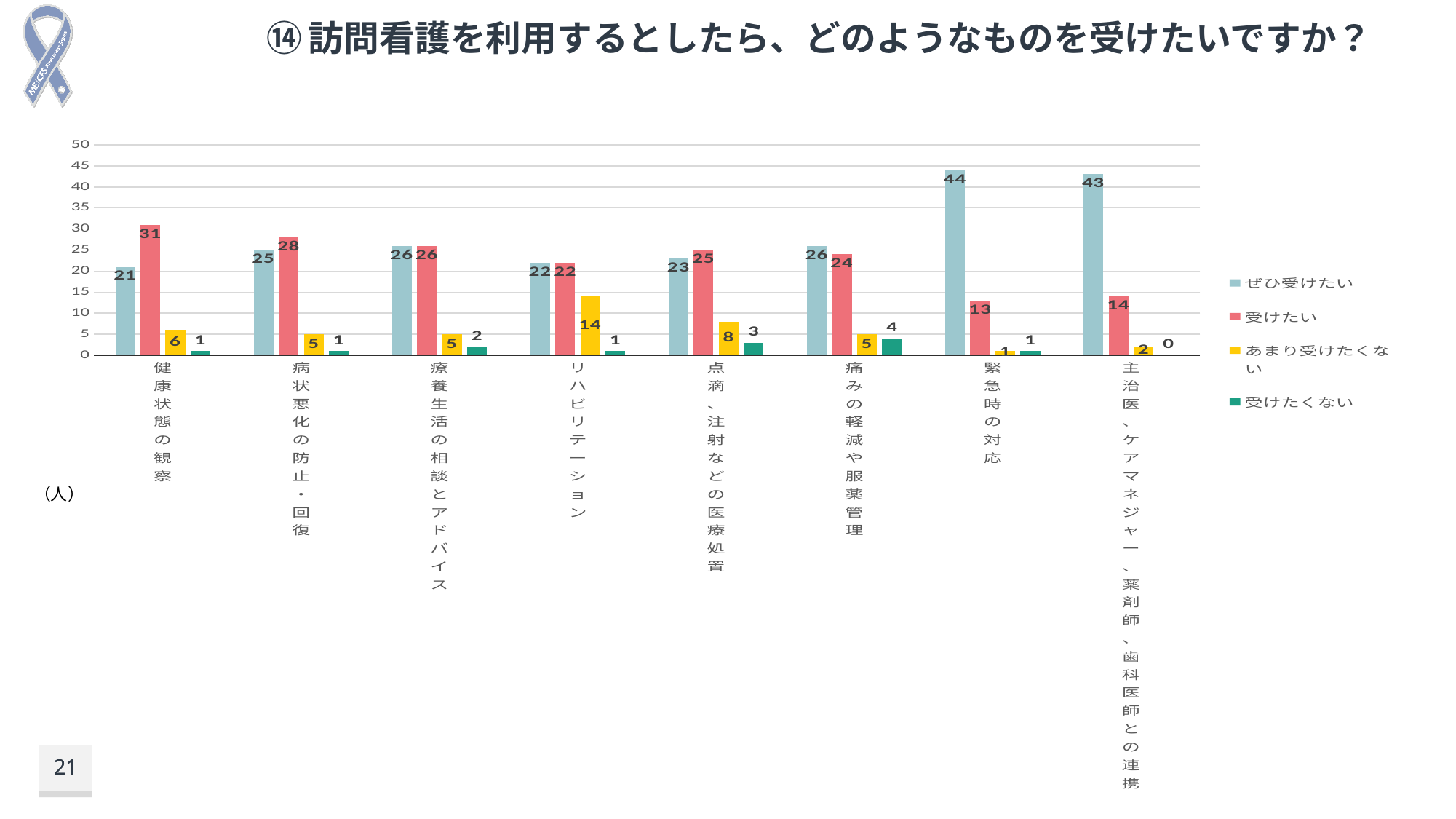
Which category has the lowest value for 受けたい? 緊急時の対応 What is the total of the four series for 主治医、ケアマネジャー、薬剤師、歯科医師との連携? 59 What is the value of あまり受けたくない for リハビリテーション? 14 How many categories are shown on the x axis? 8 What is the value of ぜひ受けたい for 緊急時の対応? 44 Which category has the highest value for ぜひ受けたい? 緊急時の対応 What is the value of 受けたくない for 痛みの軽減や服薬管理? 4 What is the difference between ぜひ受けたい and 受けたい for 緊急時の対応? 31 What kind of chart is shown on the slide? bar chart What is the value of 受けたい for 健康状態の観察? 31 How many series does the legend list? 4 For 健康状態の観察, which is larger: ぜひ受けたい or 受けたい? 受けたい